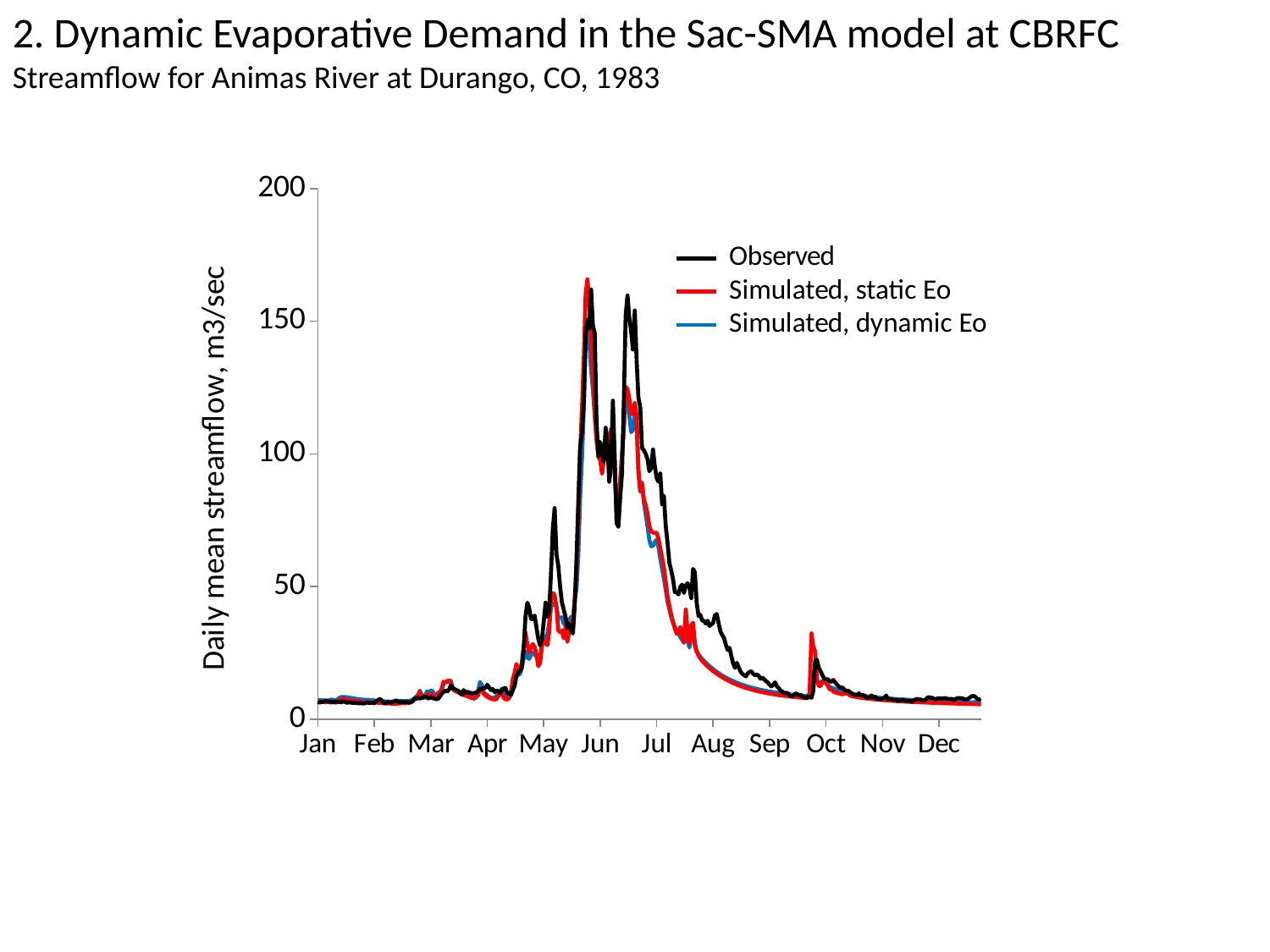
How many month labels are shown along the x axis? 12 Is the peak value of the Simulated, dynamic Eo series greater or less than 100? greater Which reaches a higher peak value, the Simulated, static Eo series or the Simulated, dynamic Eo series? Simulated, static Eo Do the Observed values rise or fall from the June peak through September? fall How many series does the legend list? 3 What kind of chart is shown on the slide? line chart What is the label on the y axis? Daily mean streamflow, m3/sec Is the peak value of the Observed series in early June greater or less than 150? greater Which series is drawn in black? Observed Do the Observed values rise or fall from January to late May? rise Is the Observed value in January greater or less than 50? less